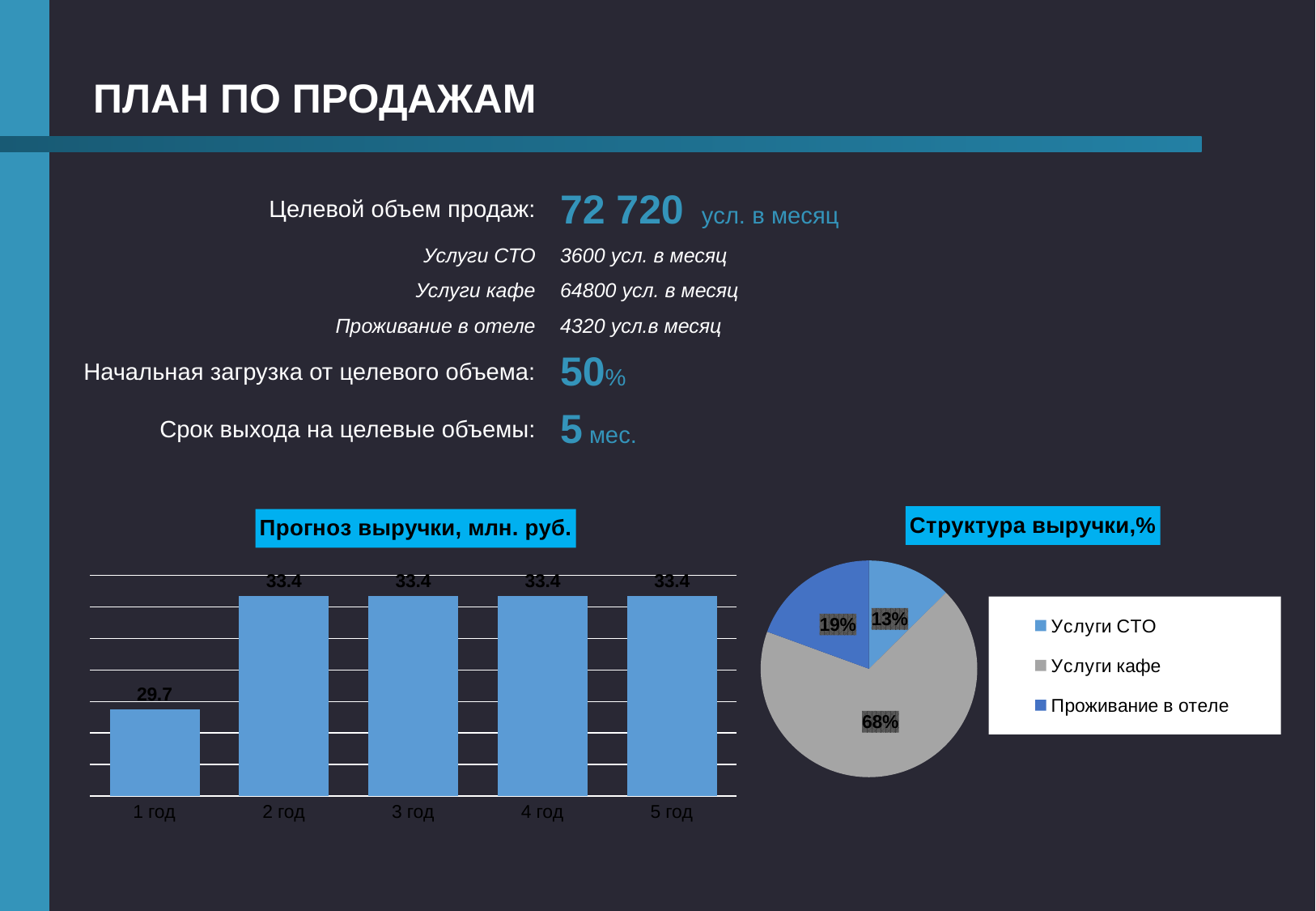
What kind of chart is 'Прогноз выручки, млн. руб.'? bar chart In the chart 'Структура выручки,%', which slice is the smallest? Услуги СТО In the chart 'Структура выручки,%', what share does 'Услуги кафе' have? 68% In the chart 'Прогноз выручки, млн. руб.', which category has the lowest value? 1 год In the chart 'Прогноз выручки, млн. руб.', what is the value for 3 год? 33.4 In the chart 'Прогноз выручки, млн. руб.', which is larger: the value for 1 год or the value for 5 год? 5 год In the chart 'Прогноз выручки, млн. руб.', do the values rise or fall from 1 год to 2 год? rise How many entries does the legend of the chart 'Структура выручки,%' list? 3 How many categories are shown in the chart 'Прогноз выручки, млн. руб.'? 5 In the chart 'Структура выручки,%', what share does 'Проживание в отеле' have? 19% In the chart 'Прогноз выручки, млн. руб.', what is the difference between the values for 2 год and 1 год? 3.7 In the chart 'Прогноз выручки, млн. руб.', what is the value for 1 год? 29.7